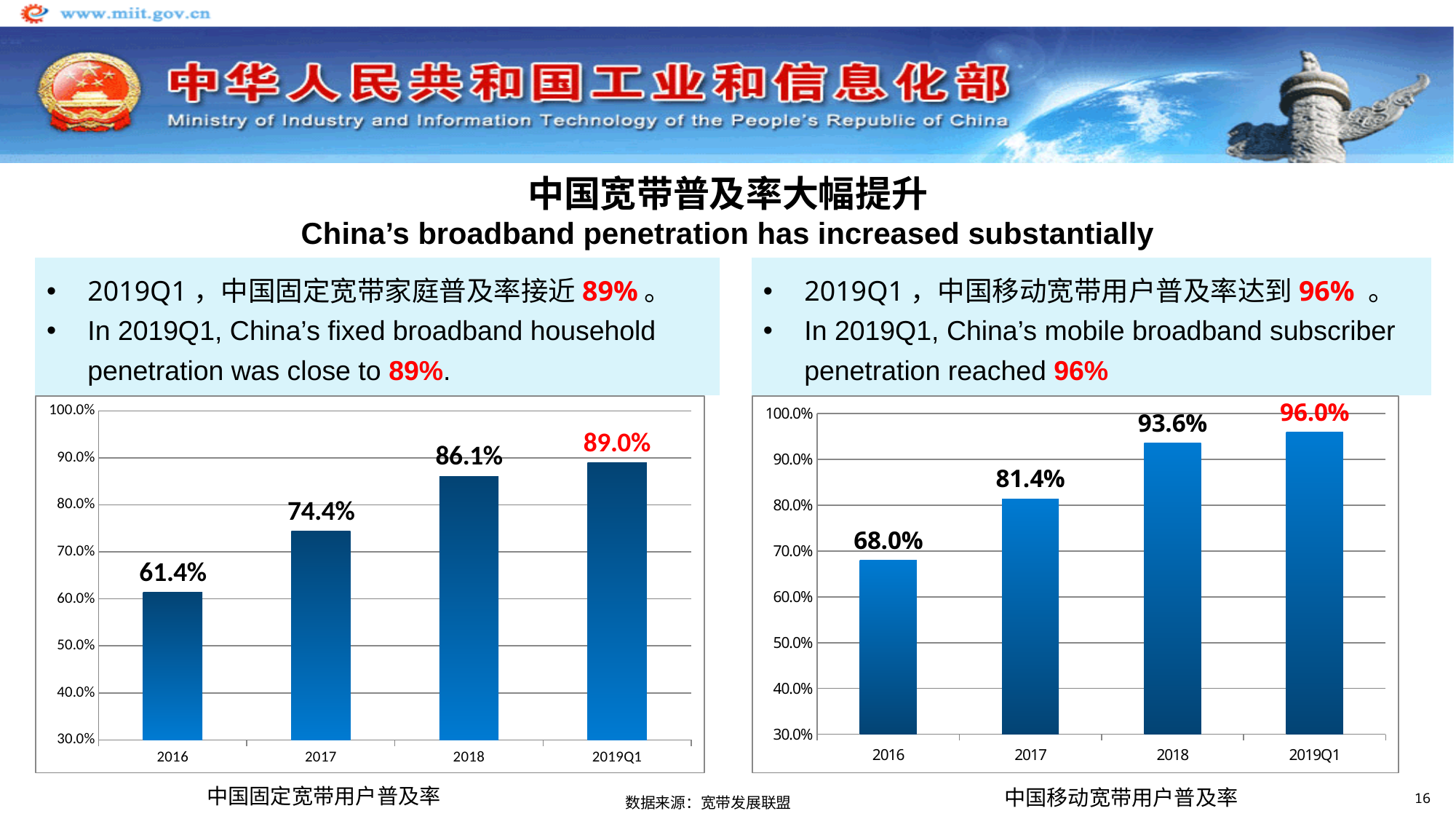
What kind of chart is the left chart (fixed broadband penetration)? Bar chart In the right chart (mobile broadband penetration), do the values rise or fall from 2016 to 2019Q1? Rise In the right chart (mobile broadband penetration), which period has the highest value? 2019Q1 In the left chart (fixed broadband penetration), which year has the lowest value? 2016 In the left chart (fixed broadband penetration), what is the lowest value shown on the vertical axis? 30.0% Which is larger: the 2018 value in the left chart (fixed broadband) or the 2018 value in the right chart (mobile broadband)? Mobile broadband (right chart), 93.6% In the right chart (mobile broadband penetration), what is the value for 2018? 93.6% In the left chart (fixed broadband penetration), is the value for 2018 greater or less than 80.0%? greater How many bars are plotted in the right chart (mobile broadband penetration)? 4 In the left chart (fixed broadband penetration), what is the difference between the 2019Q1 value and the 2016 value? 27.6% In the right chart (mobile broadband penetration), what is the difference between the 2017 value and the 2016 value? 13.4% In the left chart (fixed broadband penetration), what is the value for 2017? 74.4%